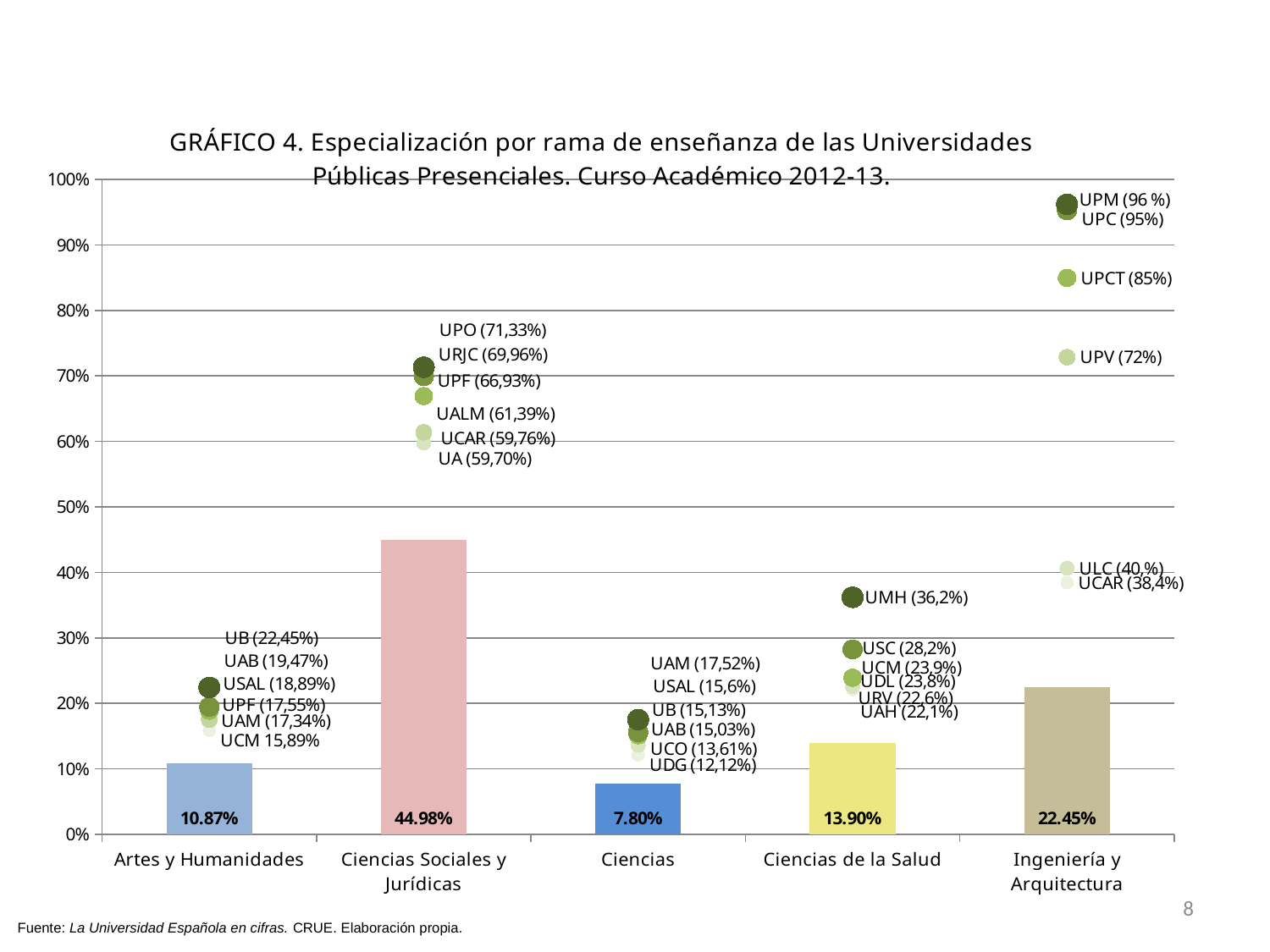
What value is shown for UPO in the Ciencias Sociales y Jurídicas category? 71,33% Which bar is larger, Ingeniería y Arquitectura or Ciencias de la Salud? Ingeniería y Arquitectura How many categories are shown on the x axis? 5 Is the bar value for Ciencias Sociales y Jurídicas greater or less than 40%? greater What is the value of the bar for Ingeniería y Arquitectura? 22.45% Which category has the lowest bar? Ciencias What kind of chart is used for the five rama de enseñanza values? bar chart What is the difference between the bar values for Ciencias de la Salud and Artes y Humanidades? 3.03% What value is shown for UPM in the Ingeniería y Arquitectura category? 96 % What is the value of the bar for Ciencias? 7.80% What is the value of the bar for Ciencias Sociales y Jurídicas? 44.98% Which category has the highest bar? Ciencias Sociales y Jurídicas